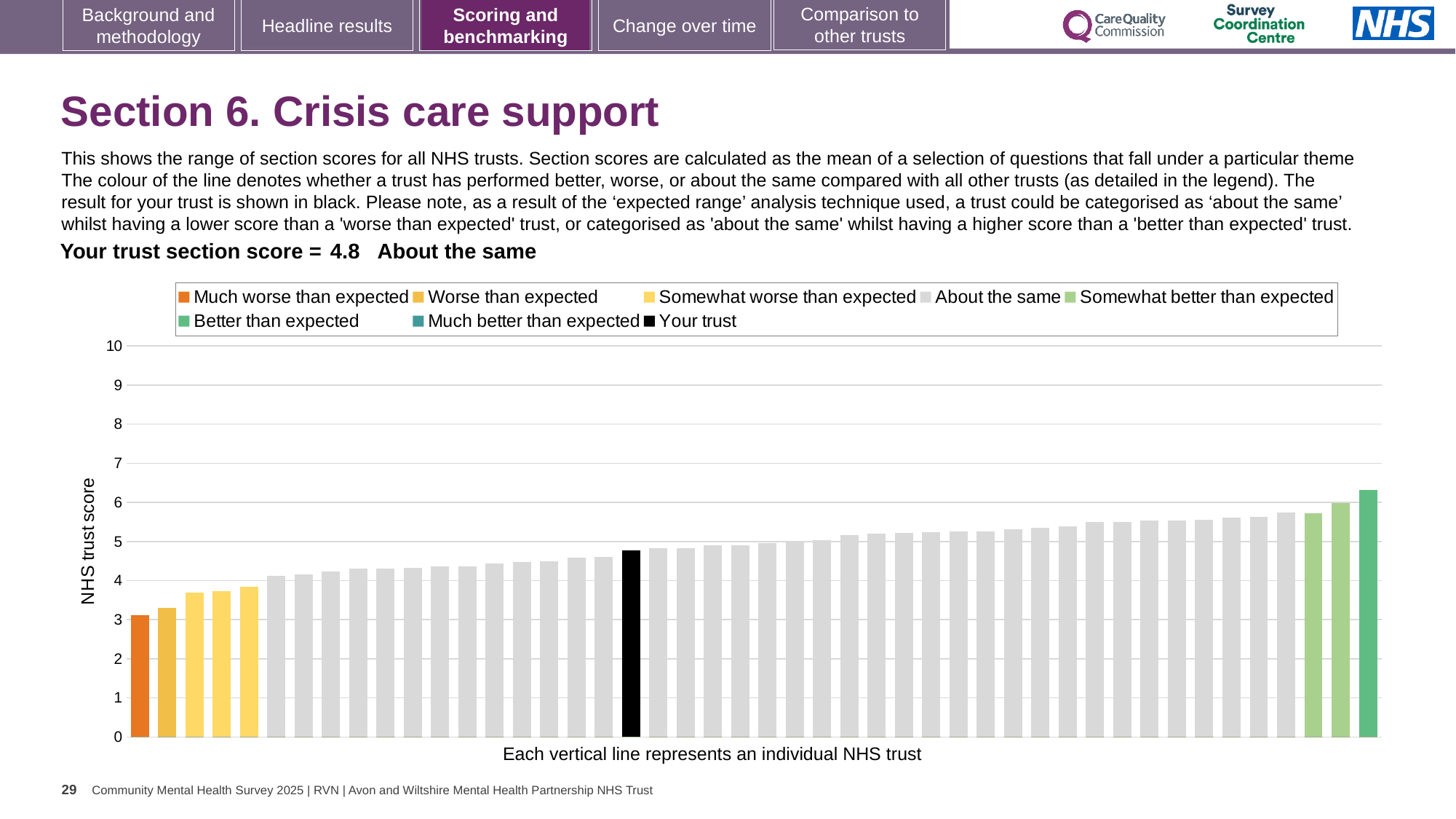
Is the value of the tallest bar greater or less than 6? greater Is the value of the tallest bar greater or less than 7? less How many entries does the chart legend list? 8 Do the bar values rise or fall from left to right along the x axis? rise What kind of chart is shown on the slide? bar chart Is the value of the black 'Your trust' bar greater or less than 5? less What is the label on the vertical axis of the chart? NHS trust score Which legend category does the highest-scoring trust belong to? Better than expected What is your trust's section score for Crisis care support? 4.8 Which legend category does the lowest-scoring trust belong to? Much worse than expected What colour is used for the 'Your trust' bar in the chart? black